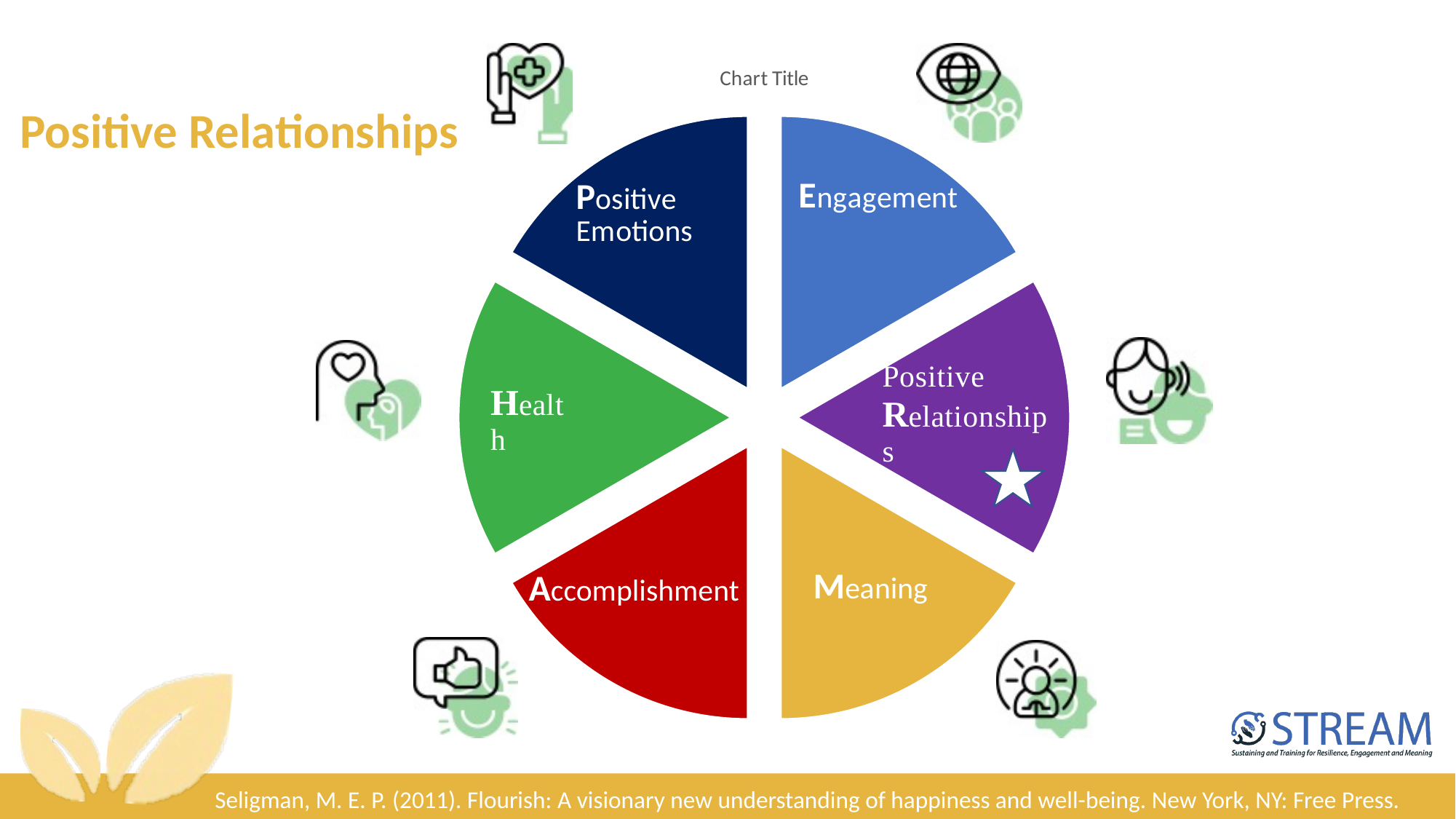
What kind of chart is shown on the slide? pie chart Which slice of the pie chart contains a white star? Positive Relationships Which slice of the pie chart is coloured purple? Positive Relationships Which slice of the pie chart is coloured red? Accomplishment Which slice of the pie chart is coloured light blue? Engagement How many slices does the pie chart have? 6